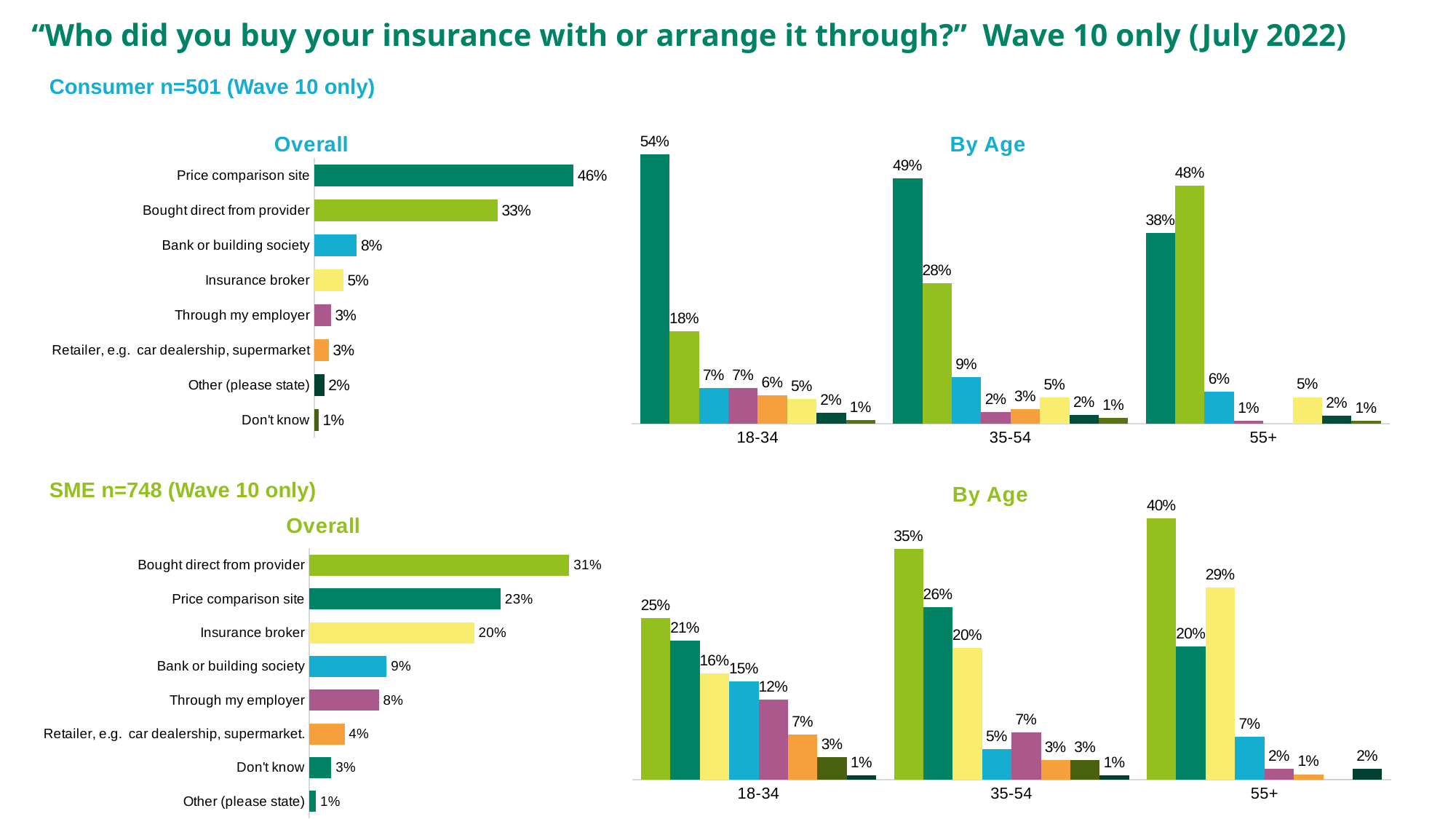
In the Consumer By Age chart, what is the value of the tallest bar in the 55+ group? 48% In the SME By Age chart, what is the value of the tallest bar in the 35-54 group? 35% In the Consumer Overall chart, what percentage bought their insurance through a price comparison site? 46% In the Consumer Overall chart, which category has the lowest value? Don't know In the SME Overall chart, what percentage bought direct from the provider? 31% In the SME Overall chart, which is larger: 'Insurance broker' or 'Bank or building society'? Insurance broker In the Consumer By Age chart, what is the value of the tallest bar in the 18-34 group? 54% In the SME Overall chart, which category has the highest value? Bought direct from provider What type of chart is the Consumer Overall chart? Bar chart In the Consumer Overall chart, what is the difference between 'Price comparison site' and 'Bought direct from provider'? 13% In the SME By Age chart, what is the difference between the tallest bar in the 55+ group and the tallest bar in the 18-34 group? 15% How many categories are shown in the Consumer Overall chart? 8